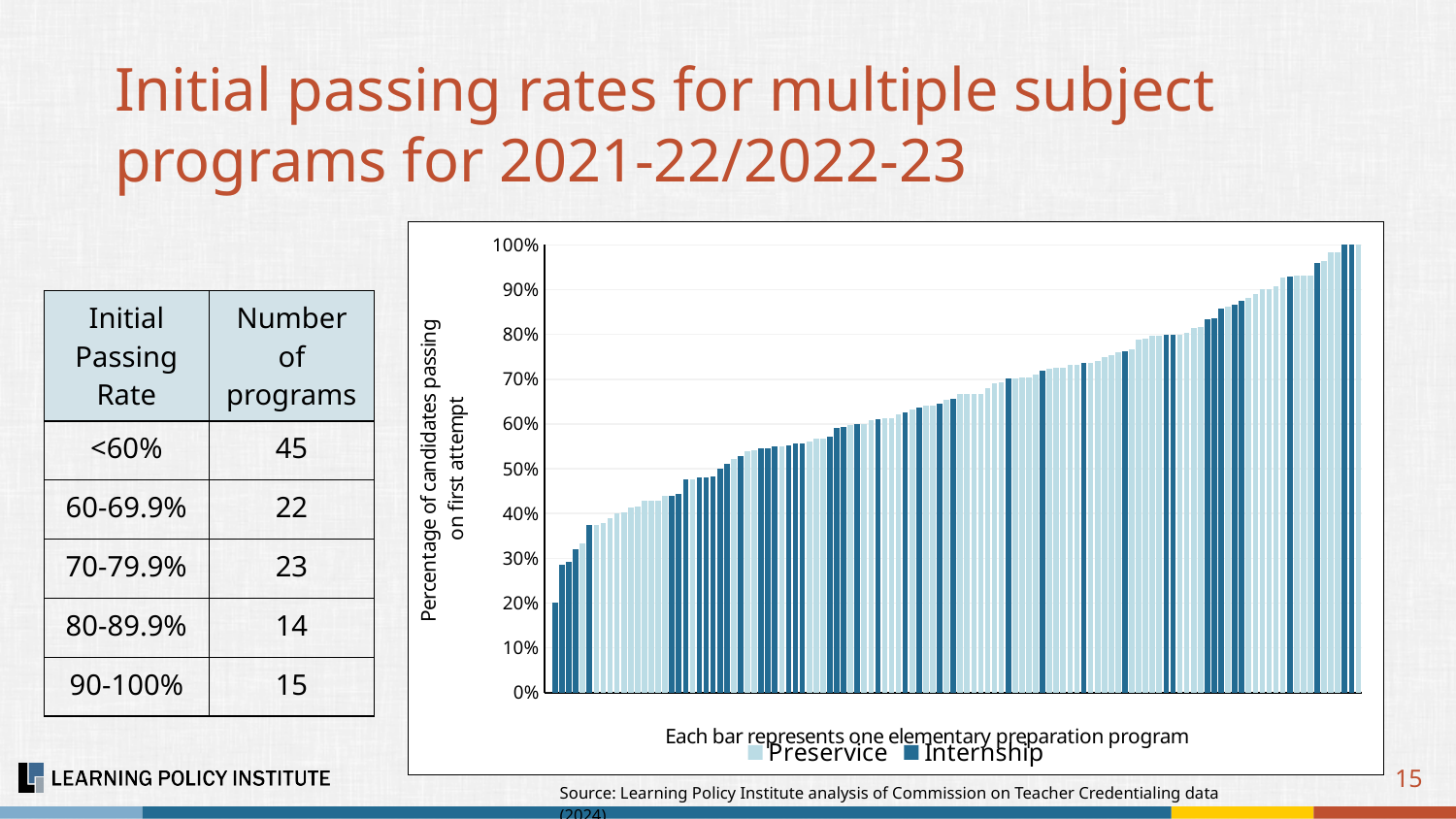
Is the value of the leftmost bar greater or less than 10%? greater What is the highest tick value shown on the chart's vertical axis? 100% Which bar is higher, the leftmost bar or the rightmost bar? The rightmost bar Do the bar values rise or fall from left to right across the chart? Rise Is the value of the rightmost (highest) bar greater or less than 90%? greater How many series does the chart's legend list? 2 What kind of chart is shown on the slide? Bar chart According to the note below the chart, what does each bar represent? One elementary preparation program What are the two series named in the chart's legend? Preservice and Internship Is the value of the leftmost (lowest) bar greater or less than 30%? less